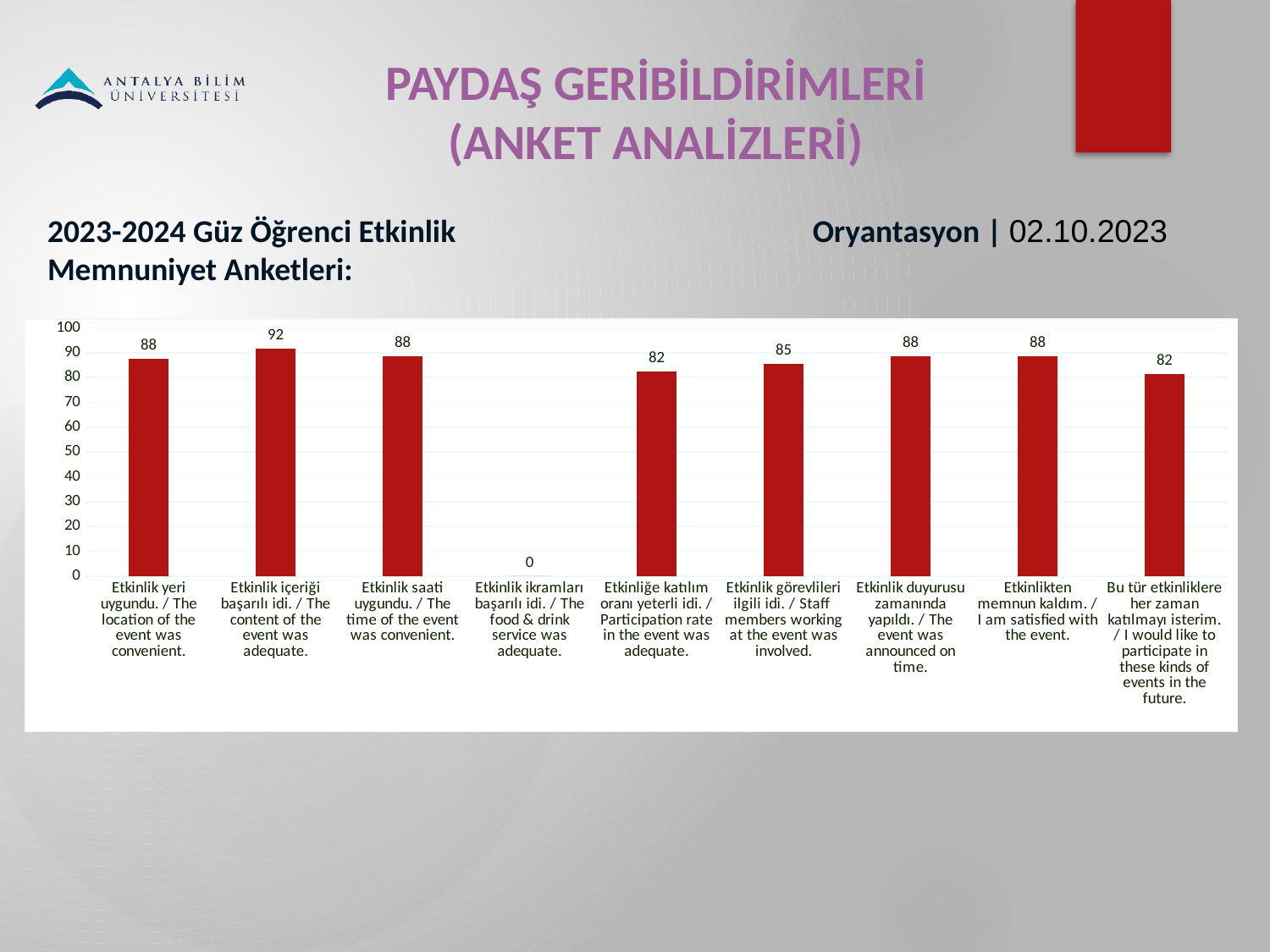
What is the value for "Etkinlik ikramları başarılı idi. / The food & drink service was adequate."? 0 What is the value for "Etkinlik içeriği başarılı idi. / The content of the event was adequate."? 92 Which category has the highest value? Etkinlik içeriği başarılı idi. / The content of the event was adequate. What is the value for "Etkinlik görevlileri ilgili idi. / Staff members working at the event was involved."? 85 Which is larger: the value for "Staff members working at the event was involved" or the value for "I would like to participate in these kinds of events in the future"? Staff members working at the event was involved What colour are the bars in the chart? red Is the value for "The event was announced on time" greater or less than 80? greater How many categories are shown on the x axis? 9 What is the difference between the value for "The content of the event was adequate" and the value for "Participation rate in the event was adequate"? 10 Which category has the lowest value? Etkinlik ikramları başarılı idi. / The food & drink service was adequate. What kind of chart is shown on the slide? bar chart What is the value for "Etkinliğe katılım oranı yeterli idi. / Participation rate in the event was adequate."? 82